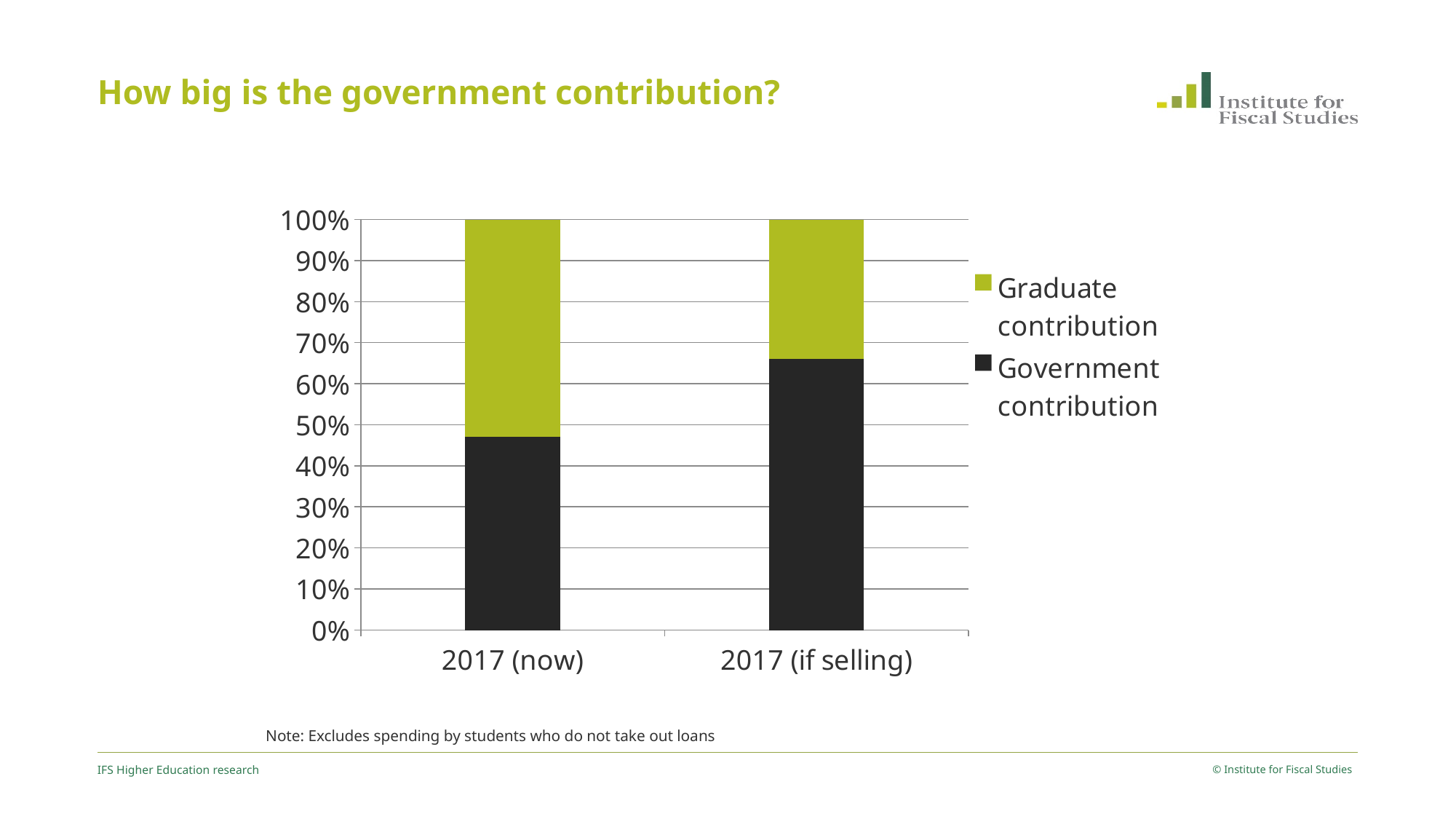
How many categories are shown on the x axis? 2 What kind of chart is shown on the slide? Stacked bar chart Is the Government contribution for 2017 (now) greater or less than 40%? greater Which category has the larger Government contribution, 2017 (now) or 2017 (if selling)? 2017 (if selling) Is the Government contribution for 2017 (now) greater or less than 50%? less Which colour represents the Government contribution in the chart? Black How many series does the legend list? 2 What is the total height of the stacked bar for 2017 (if selling)? 100% Which category has the larger Graduate contribution, 2017 (now) or 2017 (if selling)? 2017 (now) Is the Government contribution for 2017 (if selling) greater or less than 60%? greater What is the title of the slide's chart? How big is the government contribution?